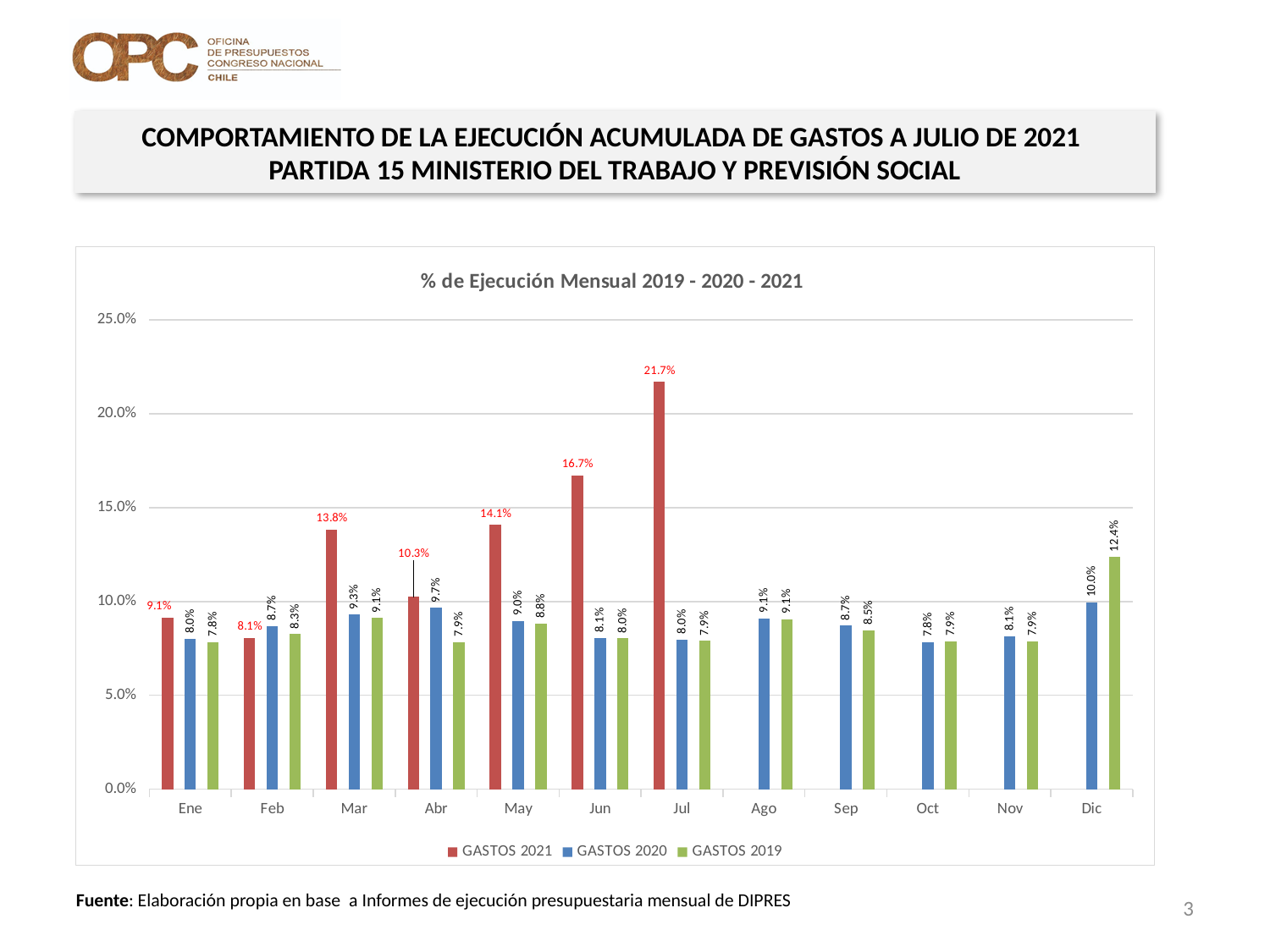
In which month is the GASTOS 2021 value highest? Jul What is the value for GASTOS 2021 in Jul? 21.7% Which is larger in Feb, GASTOS 2021 or GASTOS 2020? GASTOS 2020 What kind of chart is shown on the slide? Bar chart What is the value for GASTOS 2020 in Abr? 9.7% What is the value for GASTOS 2019 in Dic? 12.4% How many months are shown on the x axis? 12 How many series does the legend list? 3 Is the value for GASTOS 2021 in Jul greater or less than 20.0%? greater What is the title of the chart? % de Ejecución Mensual 2019 - 2020 - 2021 In which month is the GASTOS 2020 value lowest? Oct What is the difference between GASTOS 2021 and GASTOS 2020 in Jun? 8.6%